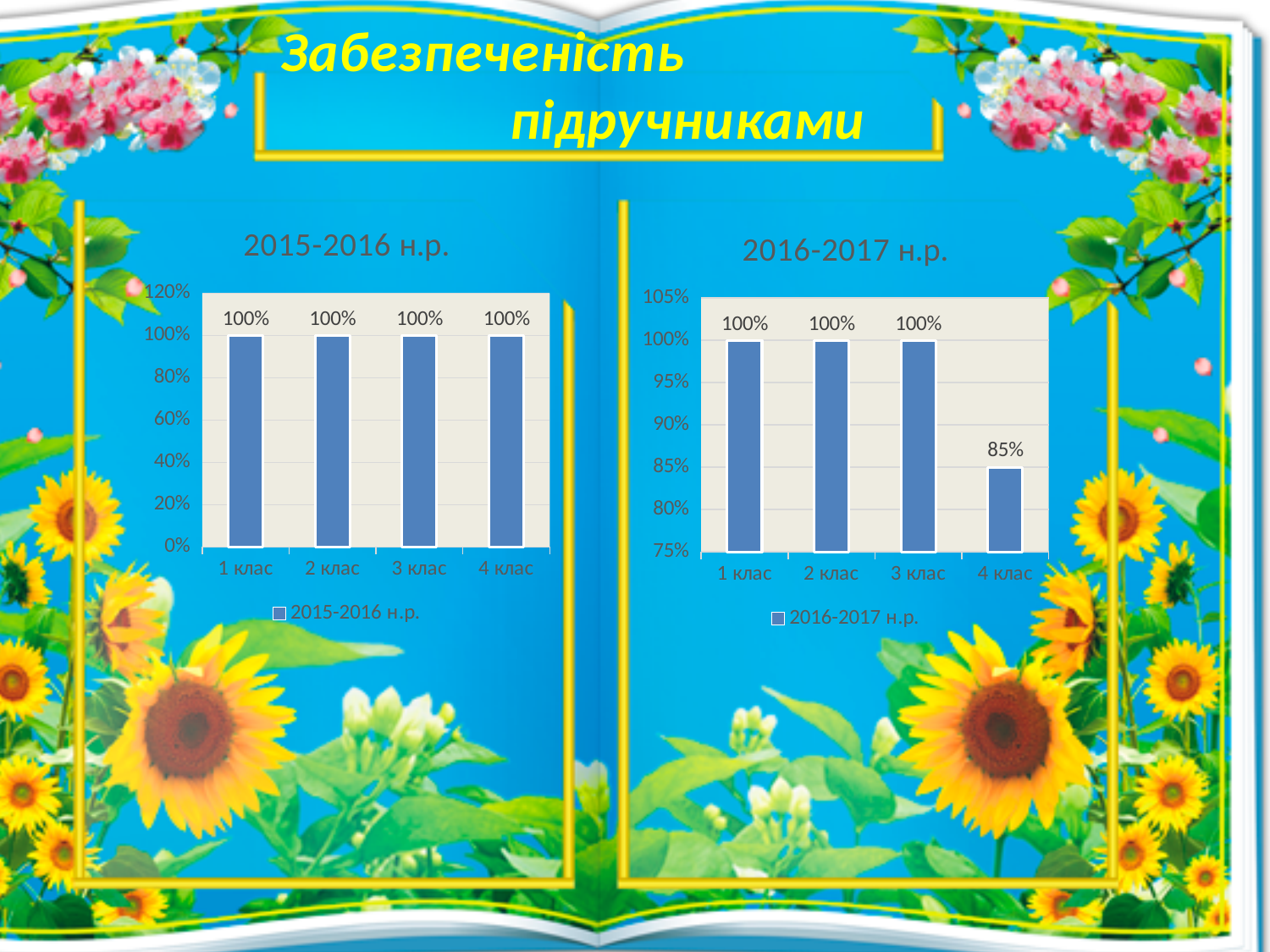
In the 2016-2017 н.р. chart, which category has the lowest value? 4 клас In the 2016-2017 н.р. chart, do the values rise, fall or stay the same from 3 клас to 4 клас? fall What is the title of the chart on the left side of the slide? 2015-2016 н.р. In the 2016-2017 н.р. chart, which is larger, the value for 2 клас or the value for 4 клас? 2 клас How many series does the legend of the 2016-2017 н.р. chart list? 1 What kind of chart is the 2015-2016 н.р. chart? bar chart In the 2016-2017 н.р. chart, is the value for 4 клас greater or less than 90%? less In the 2016-2017 н.р. chart, what is the value for 4 клас? 85% How many categories are shown in the 2015-2016 н.р. chart? 4 In the 2016-2017 н.р. chart, what is the value for 1 клас? 100% In the 2015-2016 н.р. chart, what is the value for 3 клас? 100% In the 2016-2017 н.р. chart, what is the difference between the values for 3 клас and 4 клас? 15%